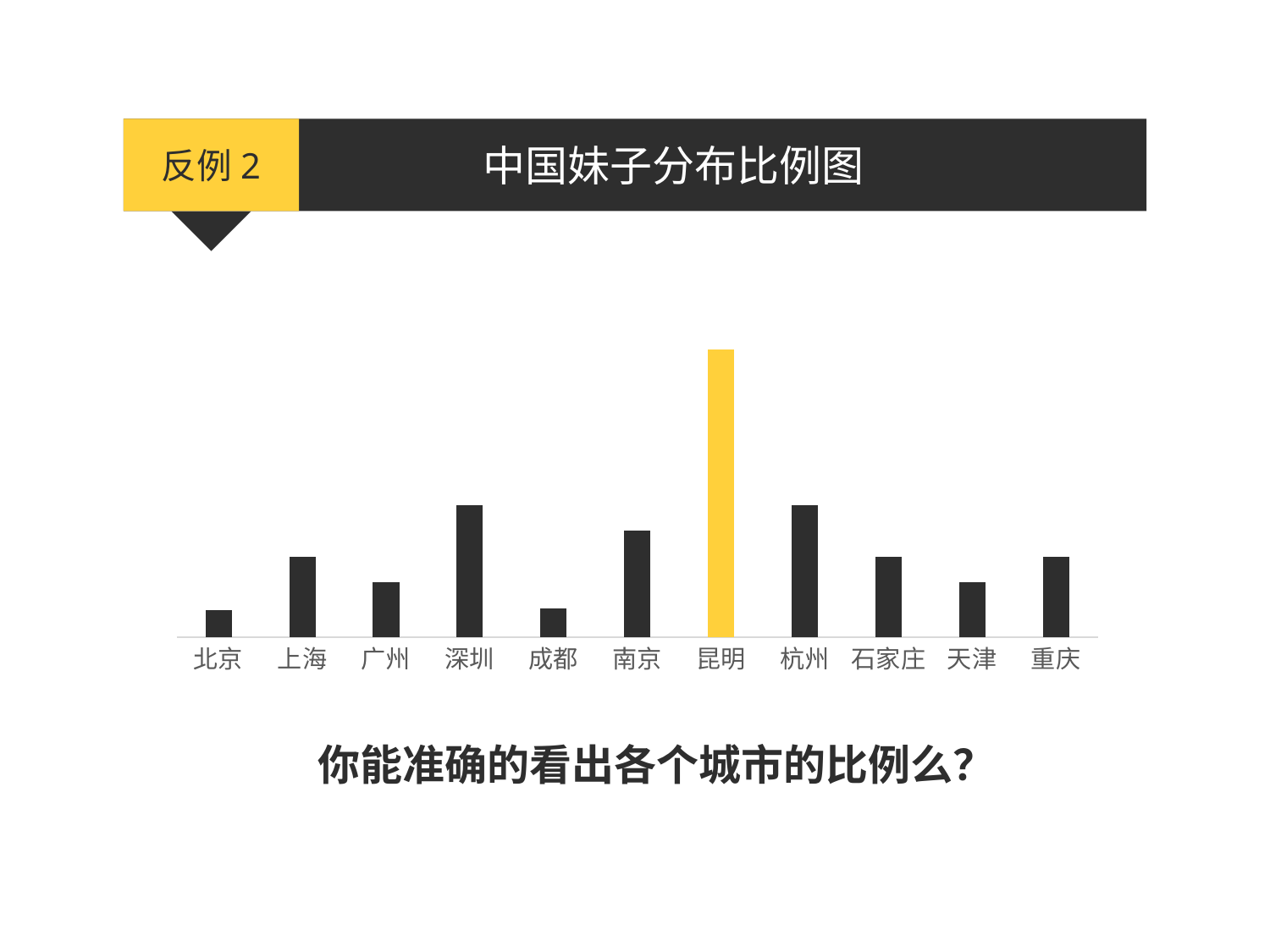
Which city has the larger value, 上海 or 北京? 上海 Which city has the larger value, 杭州 or 天津? 杭州 Which city has the larger value, 昆明 or 杭州? 昆明 Which city has the highest bar in the chart? 昆明 What kind of chart is shown on the slide? Bar chart How many cities are shown on the x axis of the chart? 11 What is the title of the chart shown on the slide? 中国妹子分布比例图 Which city's bar is highlighted in yellow? 昆明